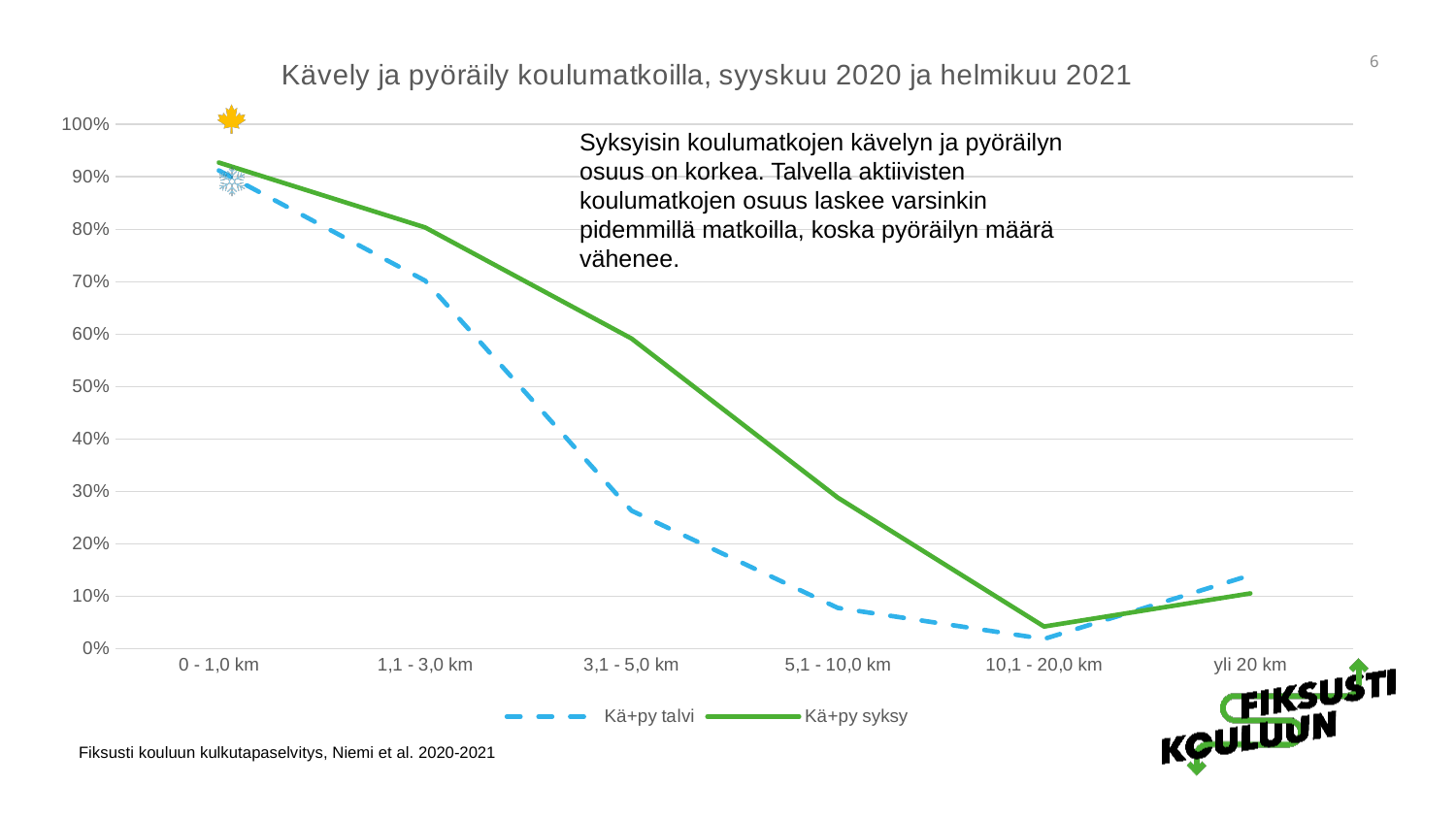
Is the value for Kä+py talvi at 5,1 - 10,0 km greater or less than 20%? less For which distance category is the Kä+py syksy value highest? 0 - 1,0 km Is the value for Kä+py syksy at 1,1 - 3,0 km greater or less than 70%? greater Which series is drawn as a dashed line? Kä+py talvi Is the value for Kä+py talvi at 0 - 1,0 km greater or less than 80%? greater How many distance categories are shown on the x axis? 6 What kind of chart is shown on the slide? line chart At 3,1 - 5,0 km, which series has the higher value, Kä+py talvi or Kä+py syksy? Kä+py syksy How many series does the legend list? 2 Does the Kä+py syksy line rise or fall from 0 - 1,0 km to 10,1 - 20,0 km? fall For which distance category is the Kä+py talvi value lowest? 10,1 - 20,0 km